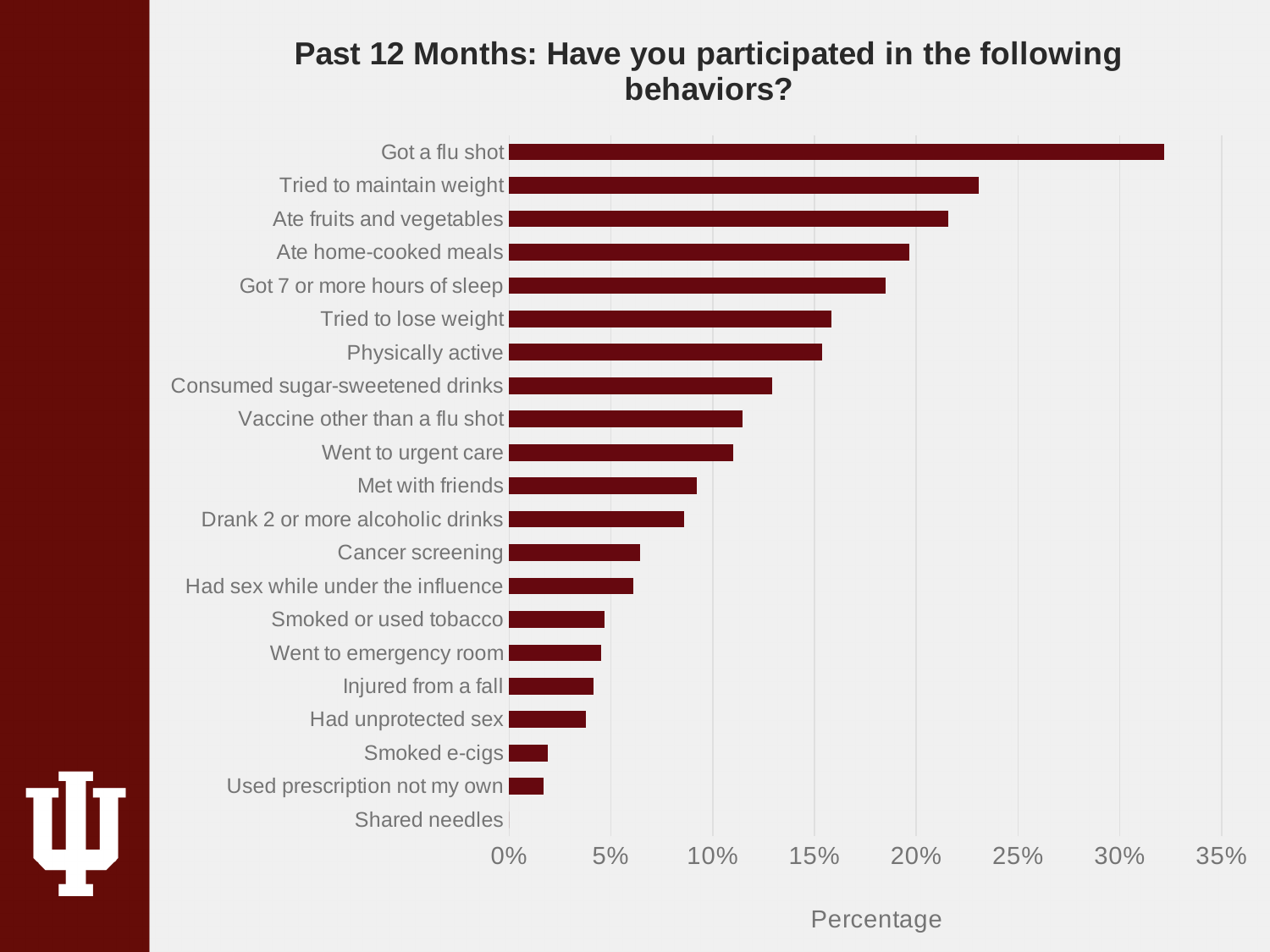
Is the value for Tried to maintain weight greater or less than 20%? greater Which behavior has the highest percentage? Got a flu shot How many behaviors are listed on the chart? 21 Is the value for Smoked e-cigs greater or less than 5%? less Is the value for Got 7 or more hours of sleep greater or less than 20%? less Which behavior has the lowest percentage? Shared needles What kind of chart is shown on the slide? bar chart Do the bar lengths increase or decrease going from the top of the chart to the bottom? decrease Which is larger, the value for Met with friends or the value for Cancer screening? Met with friends What is the label on the horizontal axis of the chart? Percentage